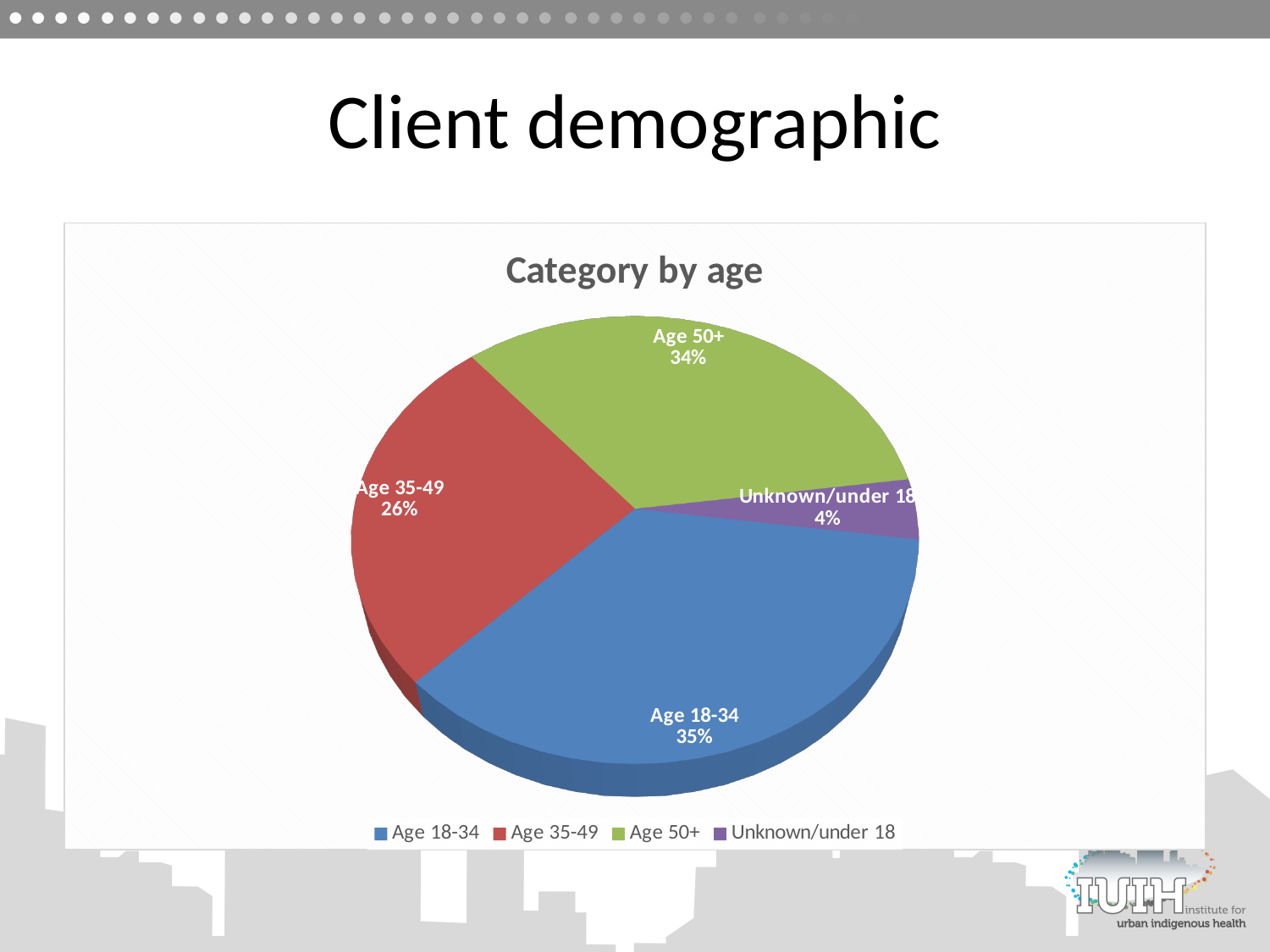
How many categories are shown in the pie chart? 4 What type of chart is shown on the slide? Pie chart Which is larger, the share for Age 35-49 or the share for Age 50+? Age 50+ What is the title of the chart? Category by age What colour is the Age 35-49 slice? Red Which age category has the smallest share of the pie? Unknown/under 18 What percentage of clients are in the Age 50+ category? 34% What is the difference in percentage points between the Age 50+ and Age 35-49 categories? 8 What percentage of clients are in the Age 35-49 category? 26% What percentage of clients are in the Age 18-34 category? 35% What percentage of clients are in the Unknown/under 18 category? 4% Which age category has the largest share of the pie? Age 18-34